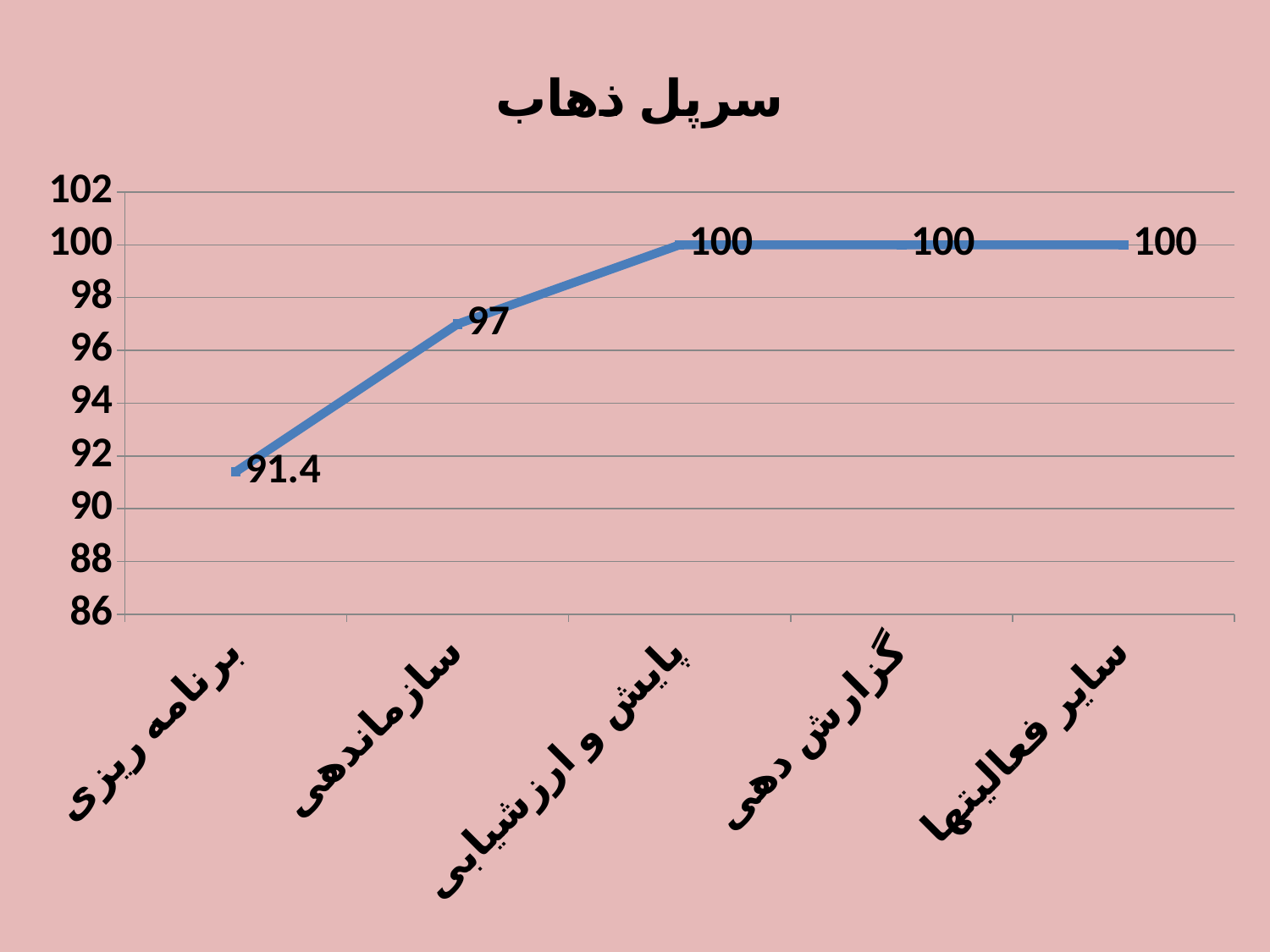
Which category has the lowest value? برنامه ریزی What is the value for گزارش دهی? 100 What is the difference between the values for پایش و ارزشیابی and سازماندهی? 3 Is the value for برنامه ریزی greater or less than 92? less How many categories are shown on the x axis? 5 What is the value for برنامه ریزی? 91.4 What is the difference between the values for سازماندهی and برنامه ریزی? 5.6 What is the title of the chart? سرپل ذهاب What is the value for پایش و ارزشیابی? 100 What kind of chart is shown on the slide? line chart Which is larger, the value for سازماندهی or the value for برنامه ریزی? سازماندهی What is the value for سازماندهی? 97